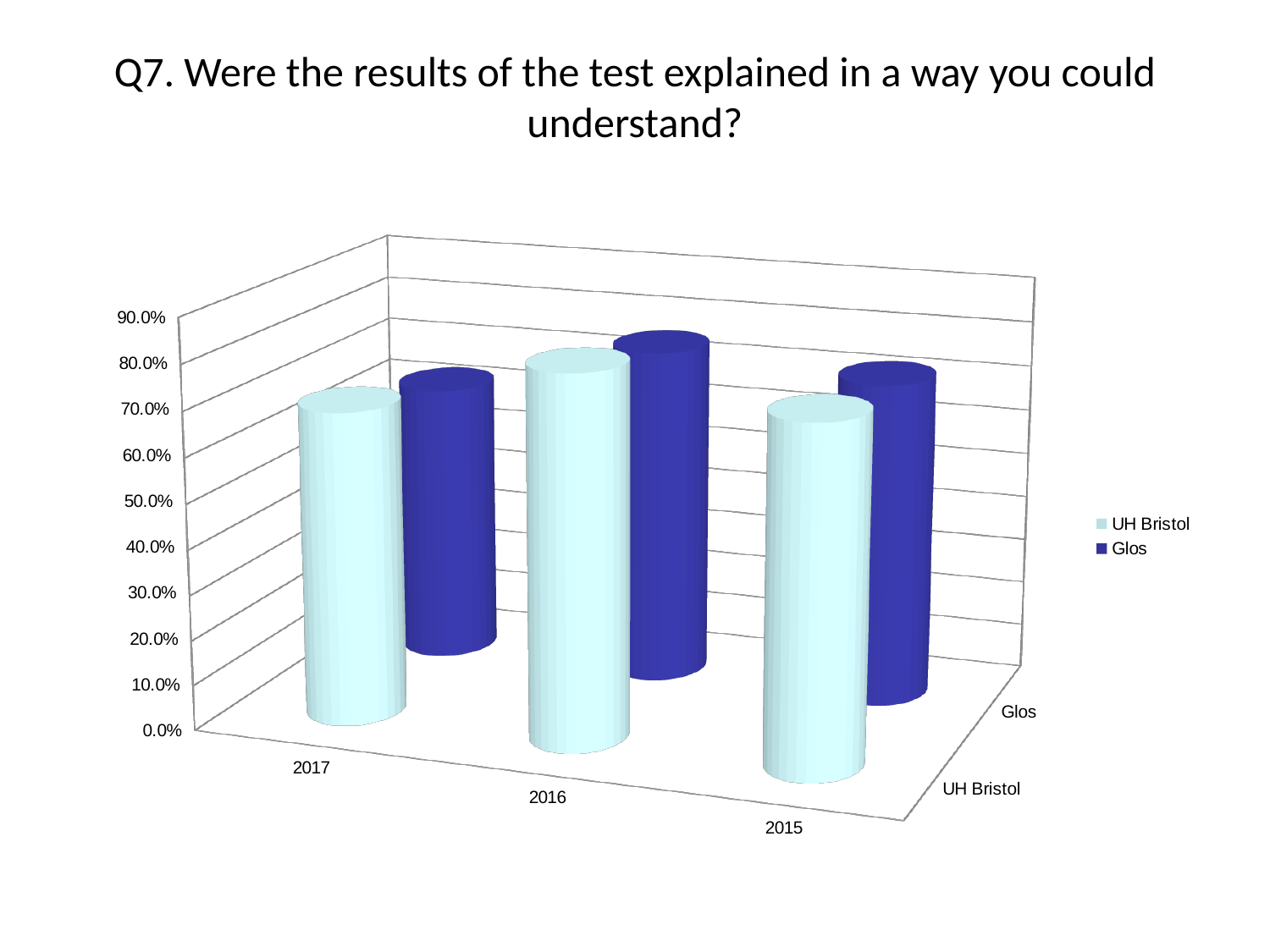
Which year has the highest value for UH Bristol? 2016 How many years are shown on the x axis of the chart? 3 Which year has the highest value for Glos? 2016 Is the value for Glos in 2017 greater or less than 40%? greater Is the value for UH Bristol in 2016 greater or less than 50%? greater Which two series are listed in the chart legend? UH Bristol and Glos What is the title of the chart? Q7. Were the results of the test explained in a way you could understand? How many series does the legend list? 2 What kind of chart is shown on the slide? bar chart Is the value for Glos in 2015 greater or less than 30%? greater